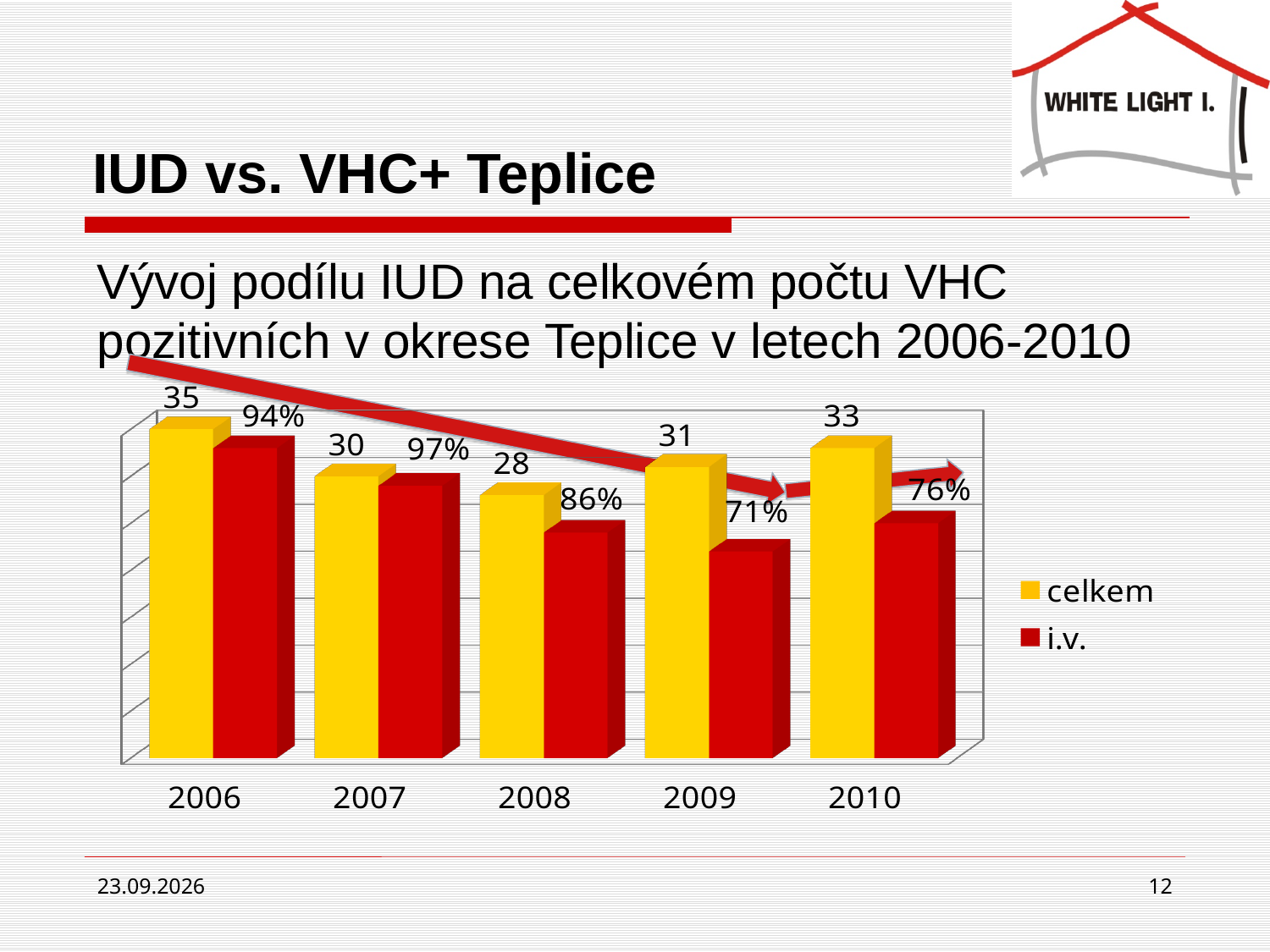
What is the label shown on the i.v. bar for 2007? 97% What is the value of the celkem series for 2006? 35 Which year has the lowest celkem value? 2008 Which year has the lowest i.v. percentage label? 2009 What is the label shown on the i.v. bar for 2009? 71% Which year has the highest celkem value? 2006 What kind of chart is shown on the slide? bar chart What is the value of the celkem series for 2010? 33 Which is larger, the celkem value for 2009 or for 2010? 2010 How many years are shown on the x axis? 5 How many series does the legend list? 2 What is the difference between the celkem values for 2006 and 2008? 7